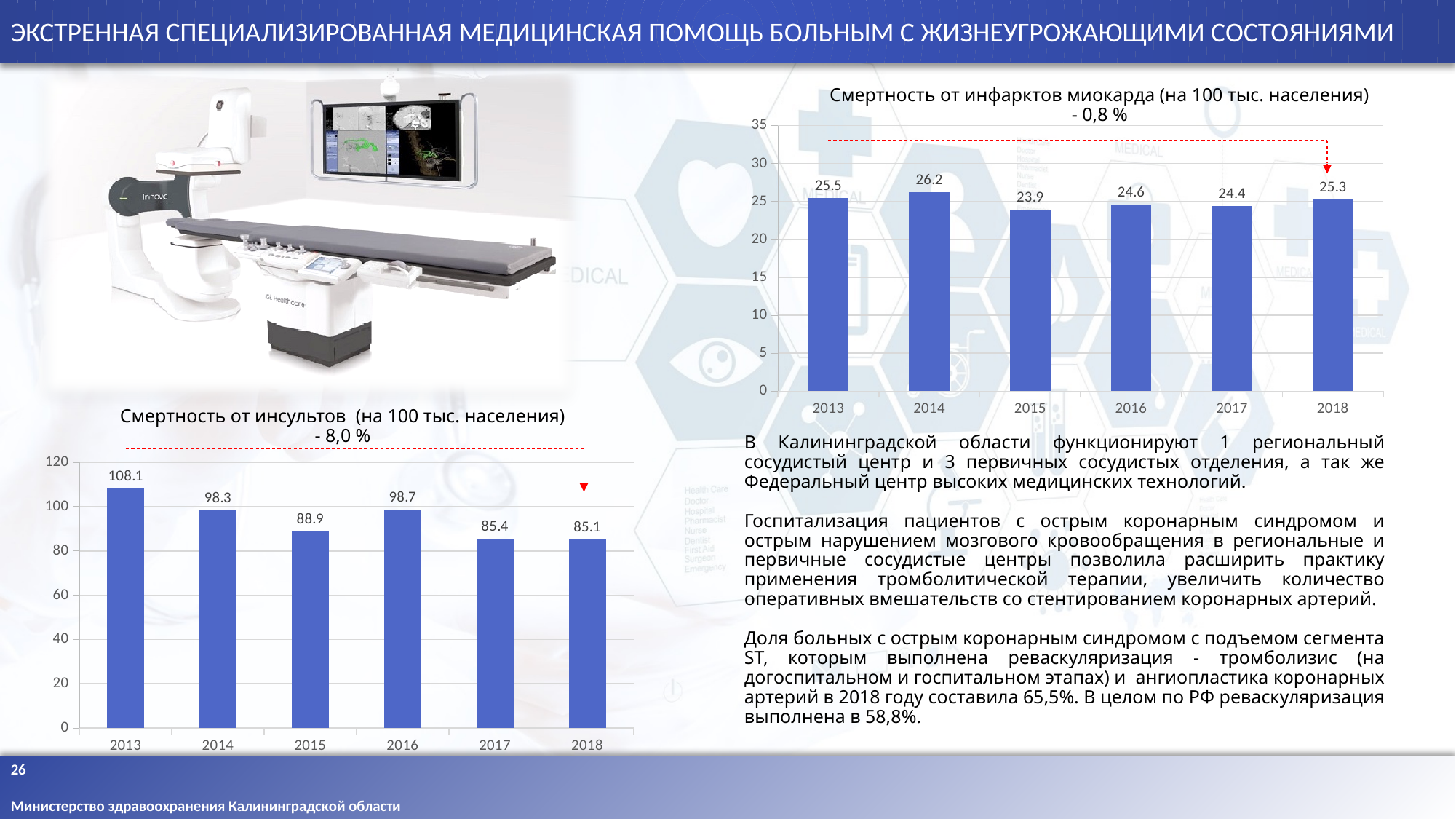
In the chart 'Смертность от инсультов (на 100 тыс. населения)', what is the value for 2018? 85.1 In the chart 'Смертность от инсультов (на 100 тыс. населения)', what is the difference between the 2013 and 2018 values? 23.0 In the chart 'Смертность от инфарктов миокарда (на 100 тыс. населения)', which year has the highest value? 2014 In the chart 'Смертность от инсультов (на 100 тыс. населения)', which year has the lowest value? 2018 In the chart 'Смертность от инфарктов миокарда (на 100 тыс. населения)', which year has the lowest value? 2015 In the chart 'Смертность от инсультов (на 100 тыс. населения)', how many years are shown? 6 What type of chart is 'Смертность от инфарктов миокарда (на 100 тыс. населения)'? Bar chart In the chart 'Смертность от инсультов (на 100 тыс. населения)', which is larger, the value for 2014 or the value for 2016? 2016 In the chart 'Смертность от инсультов (на 100 тыс. населения)', what is the value for 2013? 108.1 In the chart 'Смертность от инфарктов миокарда (на 100 тыс. населения)', what is the difference between the 2014 and 2015 values? 2.3 In the chart 'Смертность от инсультов (на 100 тыс. населения)', what percentage change is stated in the title? - 8,0 % In the chart 'Смертность от инфарктов миокарда (на 100 тыс. населения)', what is the value for 2015? 23.9